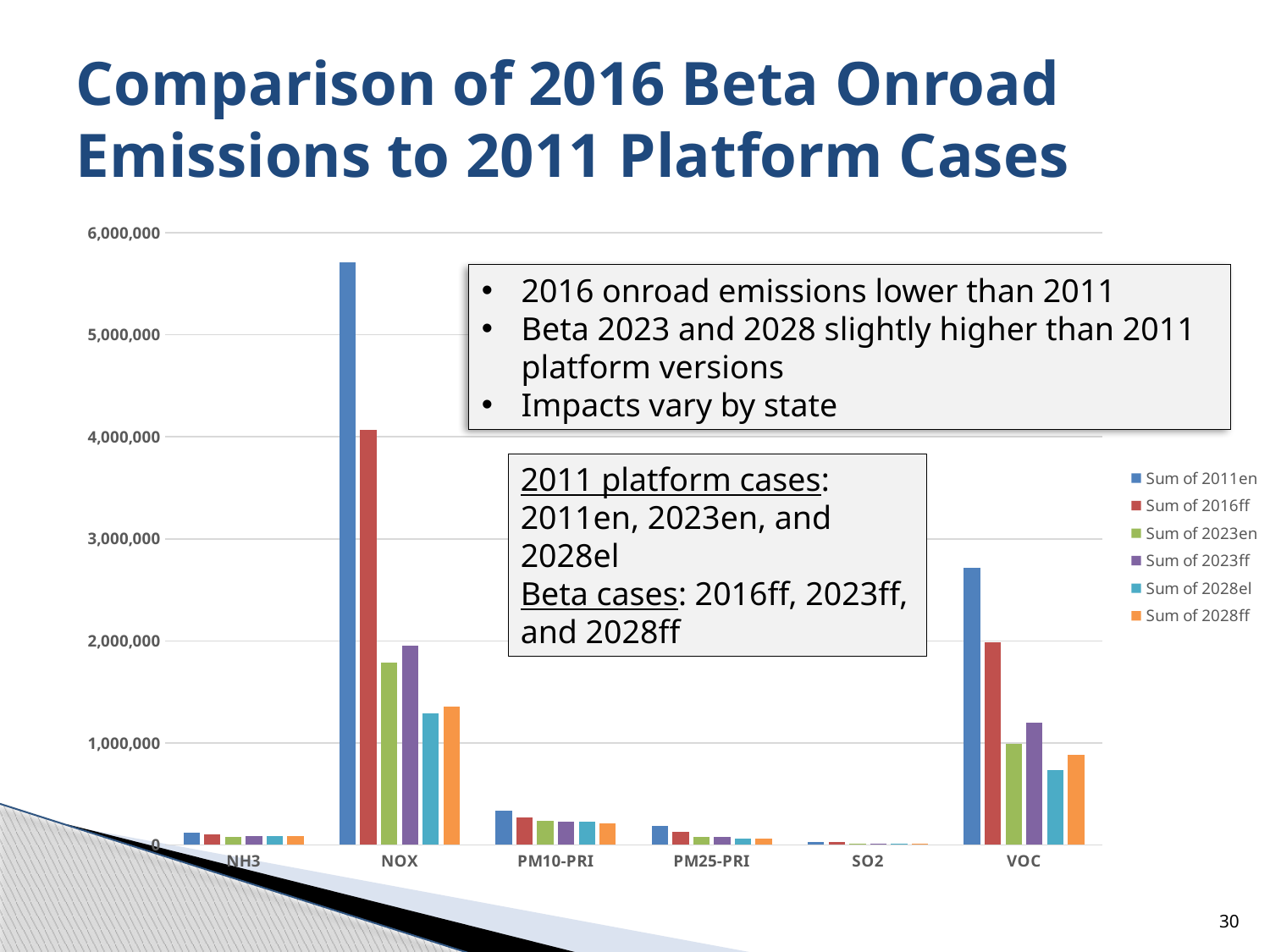
For NOX, which is larger: Sum of 2011en or Sum of 2016ff? Sum of 2011en Is the value for Sum of 2011en at VOC greater or less than 2,000,000? greater How many series does the legend list? 6 Which pollutant category has the lowest bars in the chart? SO2 Is the value for Sum of 2011en at NOX greater or less than 5,000,000? greater For VOC, which is larger: Sum of 2011en or Sum of 2028el? Sum of 2011en How many pollutant categories are shown on the x axis? 6 Which pollutant category has the tallest bar in the chart? NOX What kind of chart is shown on the slide? bar chart Is the value for Sum of 2028ff at NOX greater or less than 1,000,000? greater Which series is listed first in the legend? Sum of 2011en